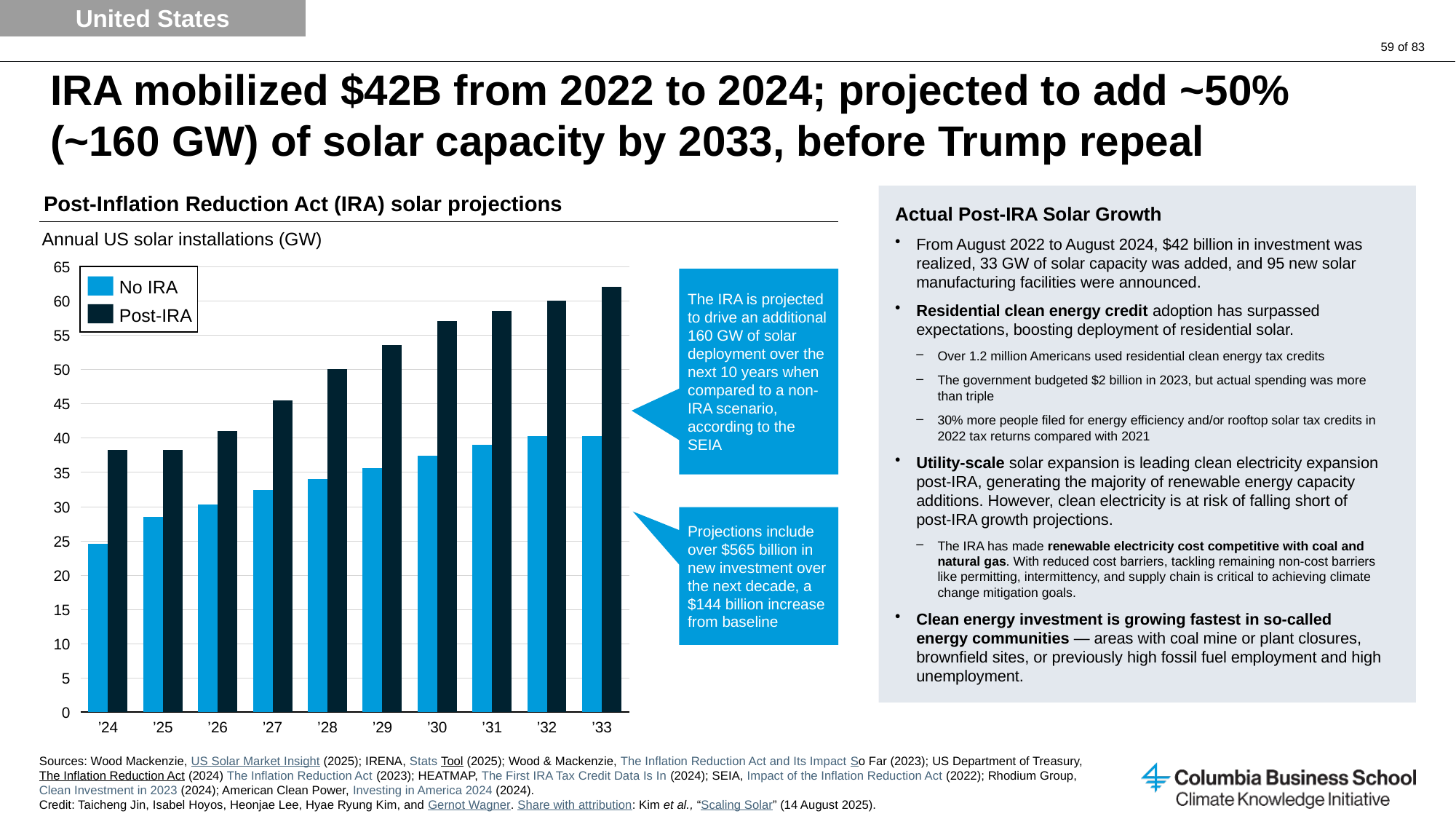
How many series does the chart legend list? 2 Do the Post-IRA values generally rise or fall from '24 to '33? rise Which legend entry is shown in dark navy? Post-IRA How many years are shown on the x axis of the chart? 10 In '30, which is larger, the No IRA value or the Post-IRA value? Post-IRA Is the Post-IRA value for '33 greater or less than 60? greater Which year has the lowest No IRA value? '24 What kind of chart is shown on the slide? bar chart Which year has the highest Post-IRA value? '33 What quantity does the chart's y axis measure, according to the subtitle? Annual US solar installations (GW)